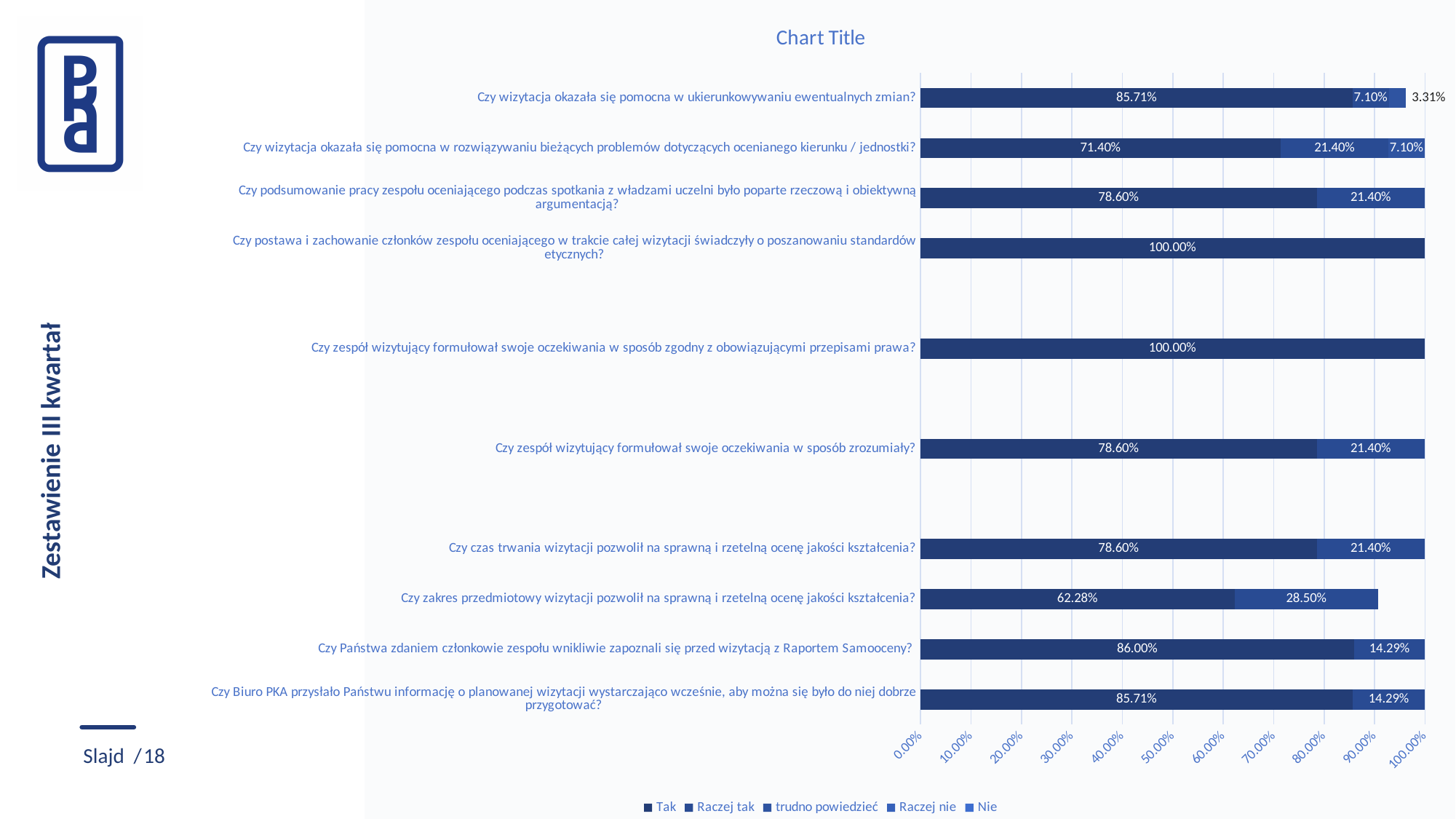
What is the title of the chart? Chart Title What is the total of the stacked bar for 'Czy wizytacja okazała się pomocna w ukierunkowywaniu ewentualnych zmian?' (85.71% + 7.10% + 3.31%)? 96.12% What is the 'Tak' value for 'Czy Państwa zdaniem członkowie zespołu wnikliwie zapoznali się przed wizytacją z Raportem Samooceny?' 86.00% How many categories show a 'Tak' value of 100.00%? 2 Which has the larger 'Tak' value: 'Czy wizytacja okazała się pomocna w ukierunkowywaniu ewentualnych zmian?' or 'Czy wizytacja okazała się pomocna w rozwiązywaniu bieżących problemów dotyczących ocenianego kierunku / jednostki?' Czy wizytacja okazała się pomocna w ukierunkowywaniu ewentualnych zmian? How many series does the legend list? 5 What is the value of the second segment of the bar for 'Czy zakres przedmiotowy wizytacji pozwolił na sprawną i rzetelną ocenę jakości kształcenia?' 28.50% Which category has the lowest 'Tak' value? Czy zakres przedmiotowy wizytacji pozwolił na sprawną i rzetelną ocenę jakości kształcenia? What is the difference between the 'Tak' values for 'Czy czas trwania wizytacji pozwolił na sprawną i rzetelną ocenę jakości kształcenia?' (78.60%) and 'Czy zakres przedmiotowy wizytacji pozwolił na sprawną i rzetelną ocenę jakości kształcenia?' (62.28%)? 16.32% What is the 'Tak' value for 'Czy zakres przedmiotowy wizytacji pozwolił na sprawną i rzetelną ocenę jakości kształcenia?' 62.28% What kind of chart is shown on the slide? Bar chart (horizontal stacked) How many categories (questions) are plotted on the chart? 10